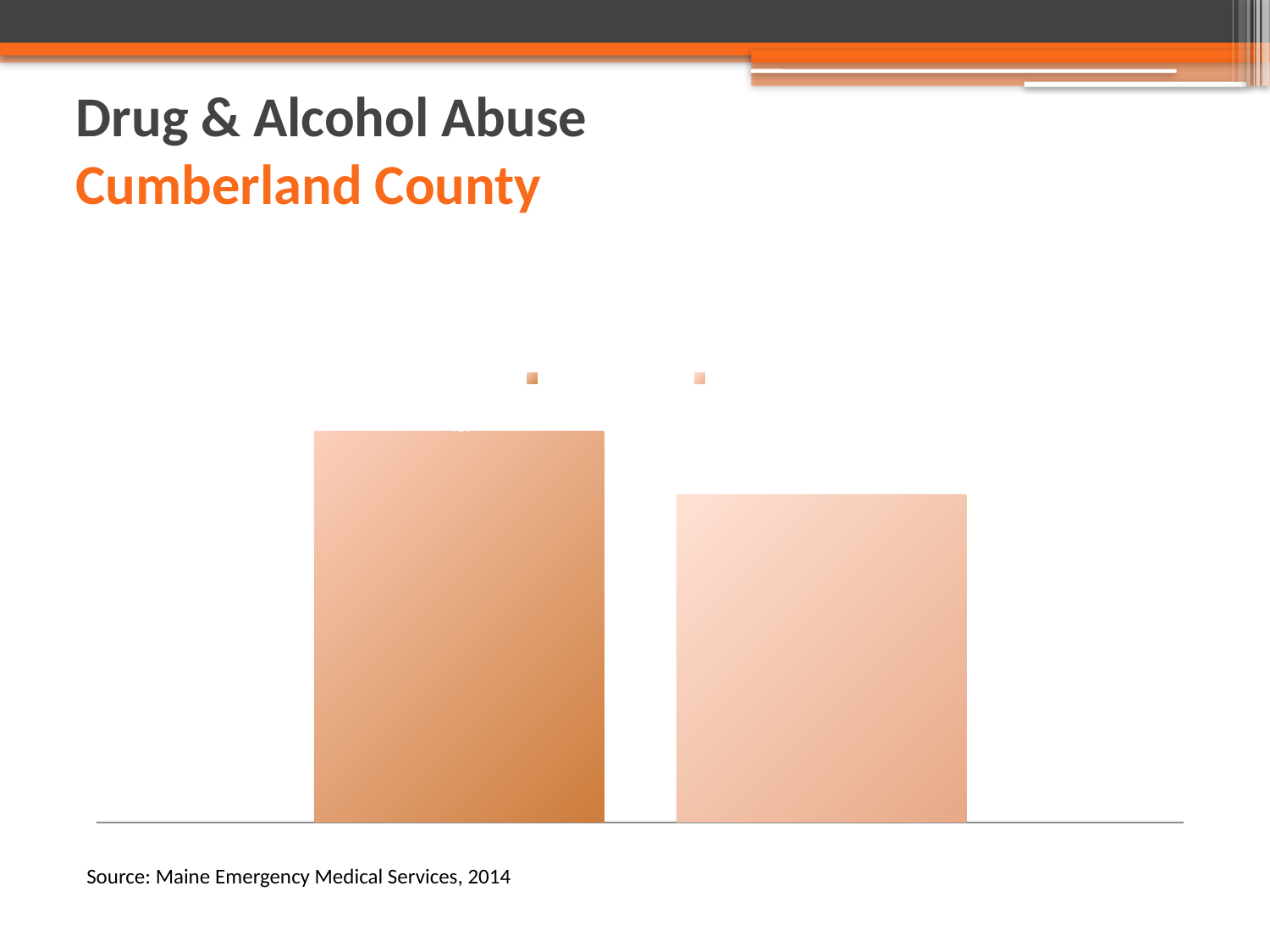
Which bar is the shortest in the chart, the left or the right? the right bar How many bars are plotted in the chart? 2 How many entries does the chart's legend show? 2 Which county does the slide title say the chart is about? Cumberland County Which bar is taller, the left bar or the right bar? the left bar What source is cited below the chart? Maine Emergency Medical Services, 2014 What kind of chart is shown on the slide? bar chart